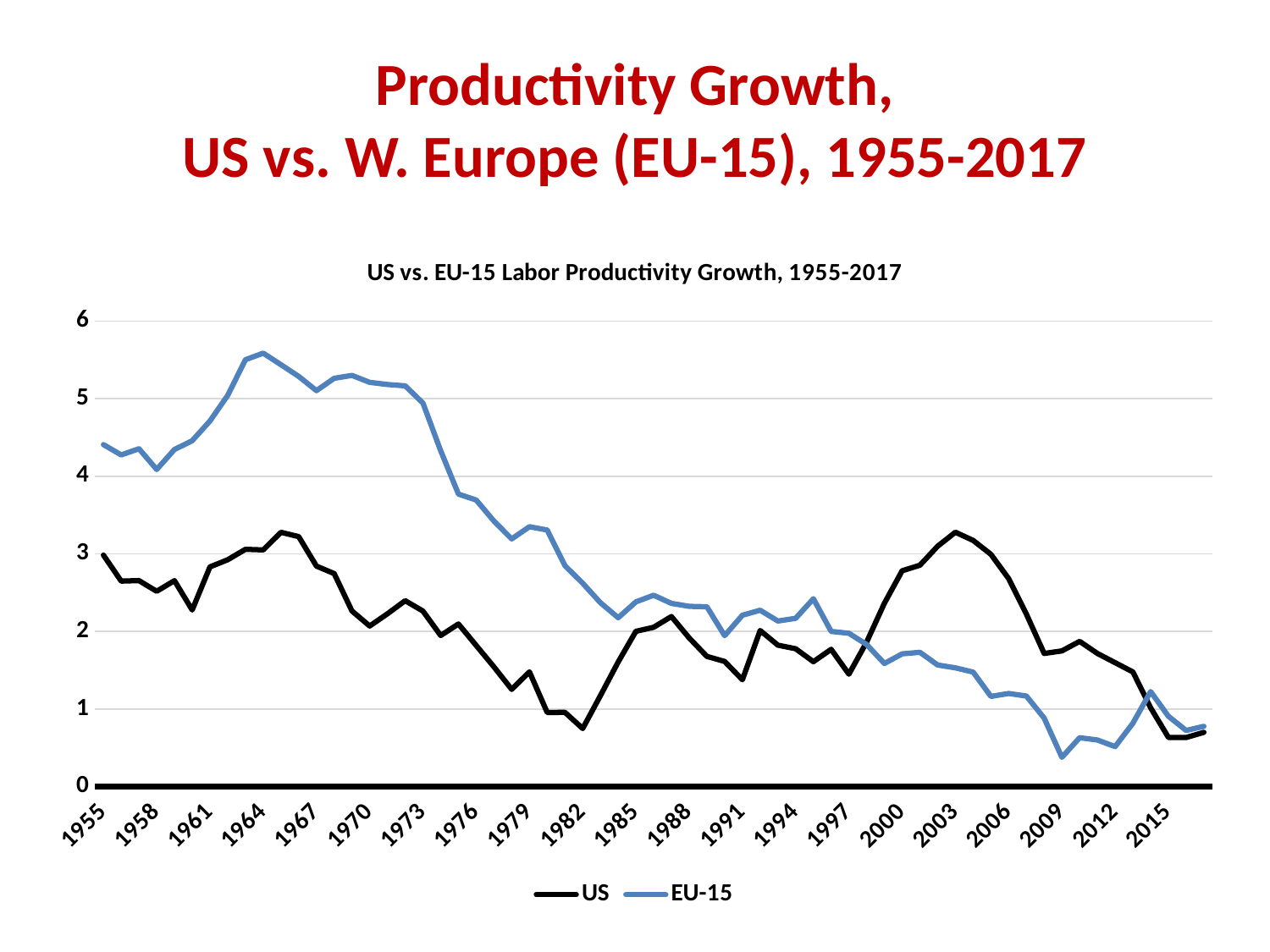
Does the EU-15 line overall rise or fall from 1955 to 2017? fall Is the EU-15 value for 1964 greater or less than 5? greater Is the US value for 1982 greater or less than 1? less Is the EU-15 value for 1955 greater or less than 4? greater What is the title printed above the chart? US vs. EU-15 Labor Productivity Growth, 1955-2017 In 1964, which series has the higher value, US or EU-15? EU-15 Which colour is used for the EU-15 line? blue What kind of chart is shown on the slide? line chart In 2003, which series has the higher value, US or EU-15? US How many series does the legend list? 2